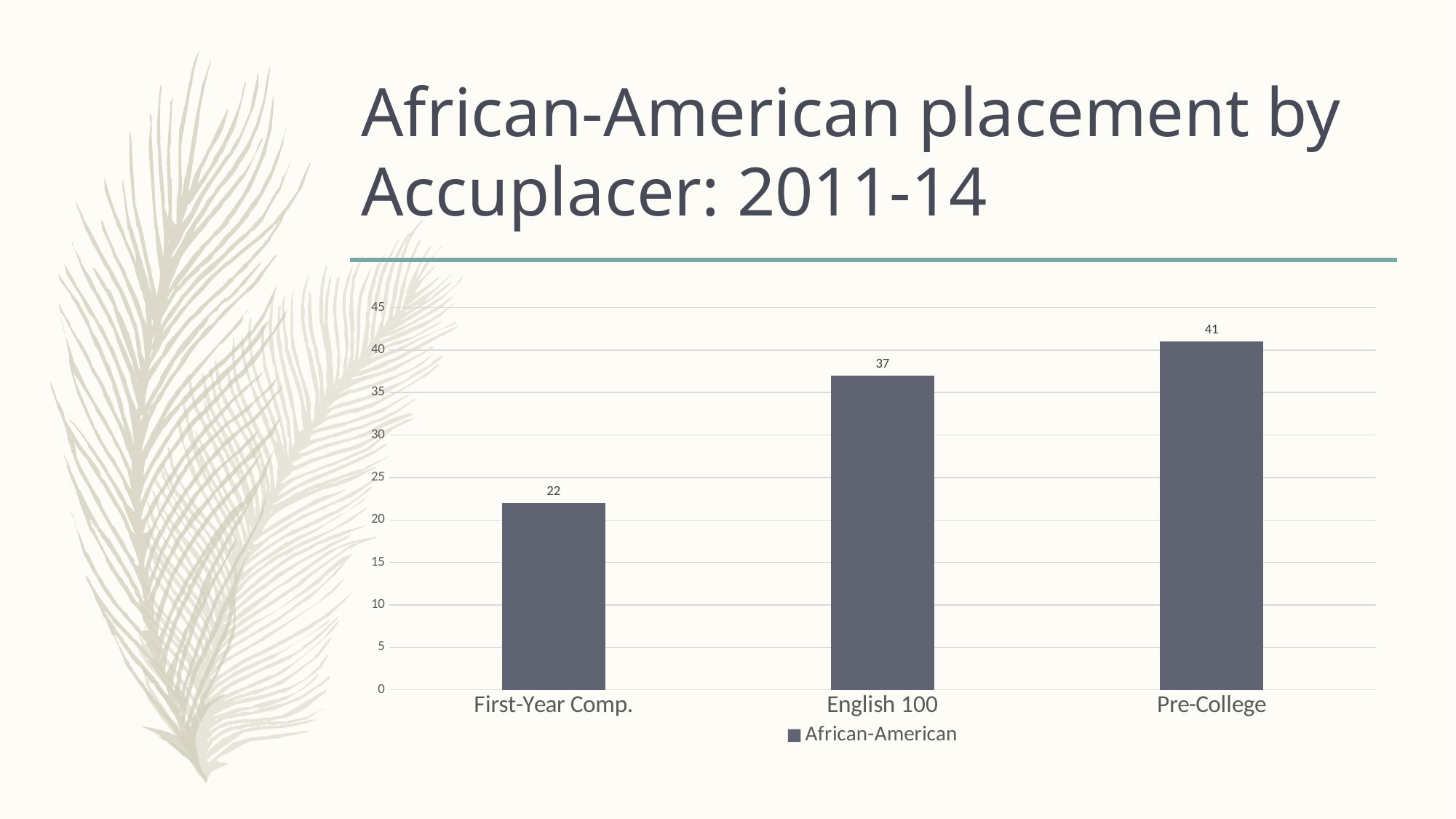
Is the value for English 100 greater or less than 35? greater What is the value for Pre-College? 41 How many categories are shown on the x axis? 3 Which is larger, the value for English 100 or the value for First-Year Comp.? English 100 What is the difference between the values for Pre-College and First-Year Comp.? 19 Which category has the highest value? Pre-College How many series does the legend list? 1 What is the difference between the values for English 100 and First-Year Comp.? 15 What is the value for English 100? 37 What kind of chart is shown on the slide? bar chart Which category has the lowest value? First-Year Comp. What is the value for First-Year Comp.? 22